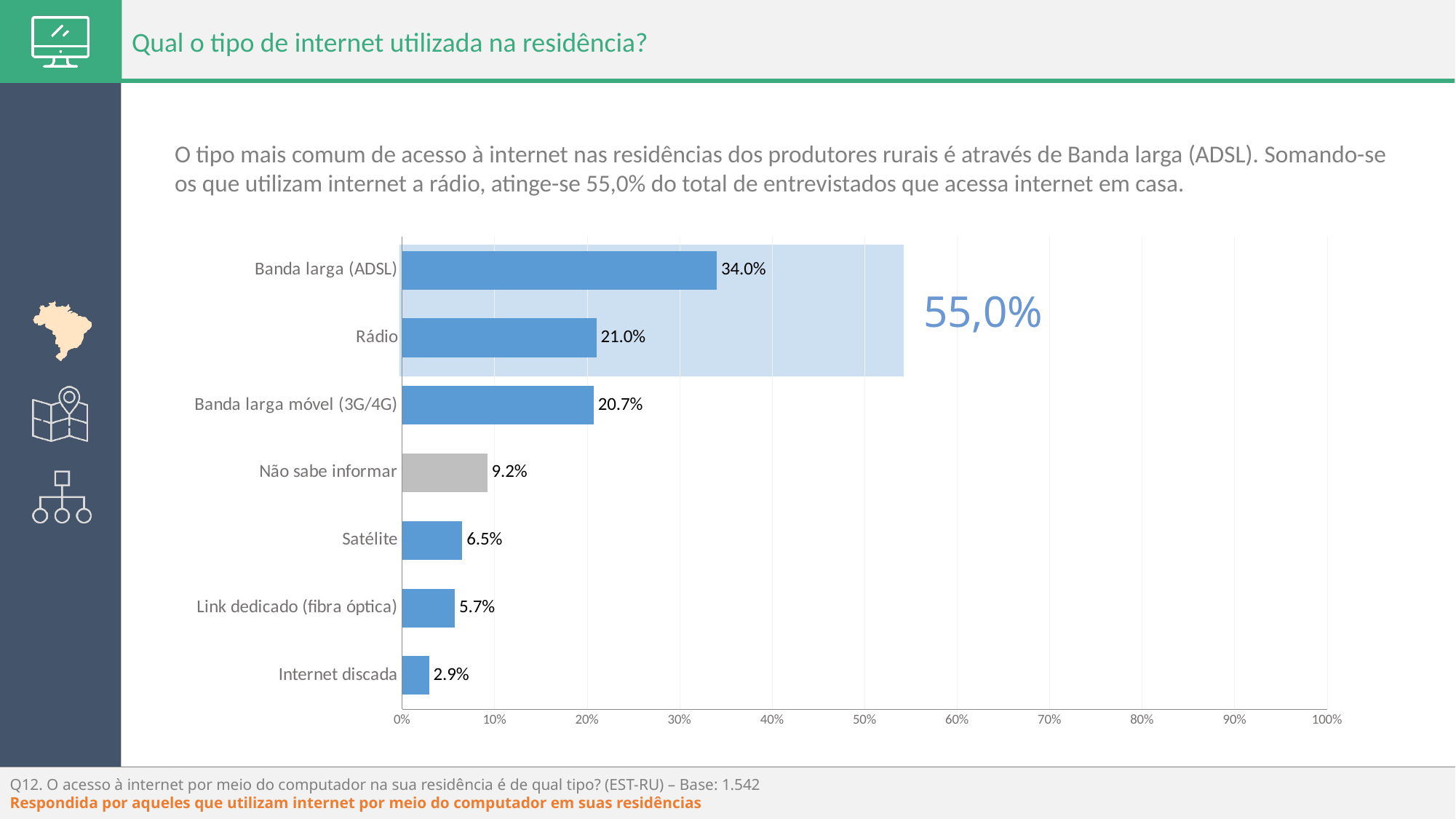
What is the difference between the values for Banda larga (ADSL) and Rádio? 13.0% What is the value for Banda larga móvel (3G/4G)? 20.7% What combined percentage is highlighted next to the Banda larga (ADSL) and Rádio bars? 55,0% Which category has the highest value? Banda larga (ADSL) What kind of chart is shown on the slide? Bar chart What is the value for Não sabe informar? 9.2% What is the value for Internet discada? 2.9% How many categories are shown in the chart? 7 Which is larger, the value for Satélite or the value for Link dedicado (fibra óptica)? Satélite What is the value for Banda larga (ADSL)? 34.0% Which category has the lowest value? Internet discada What is the value for Rádio? 21.0%